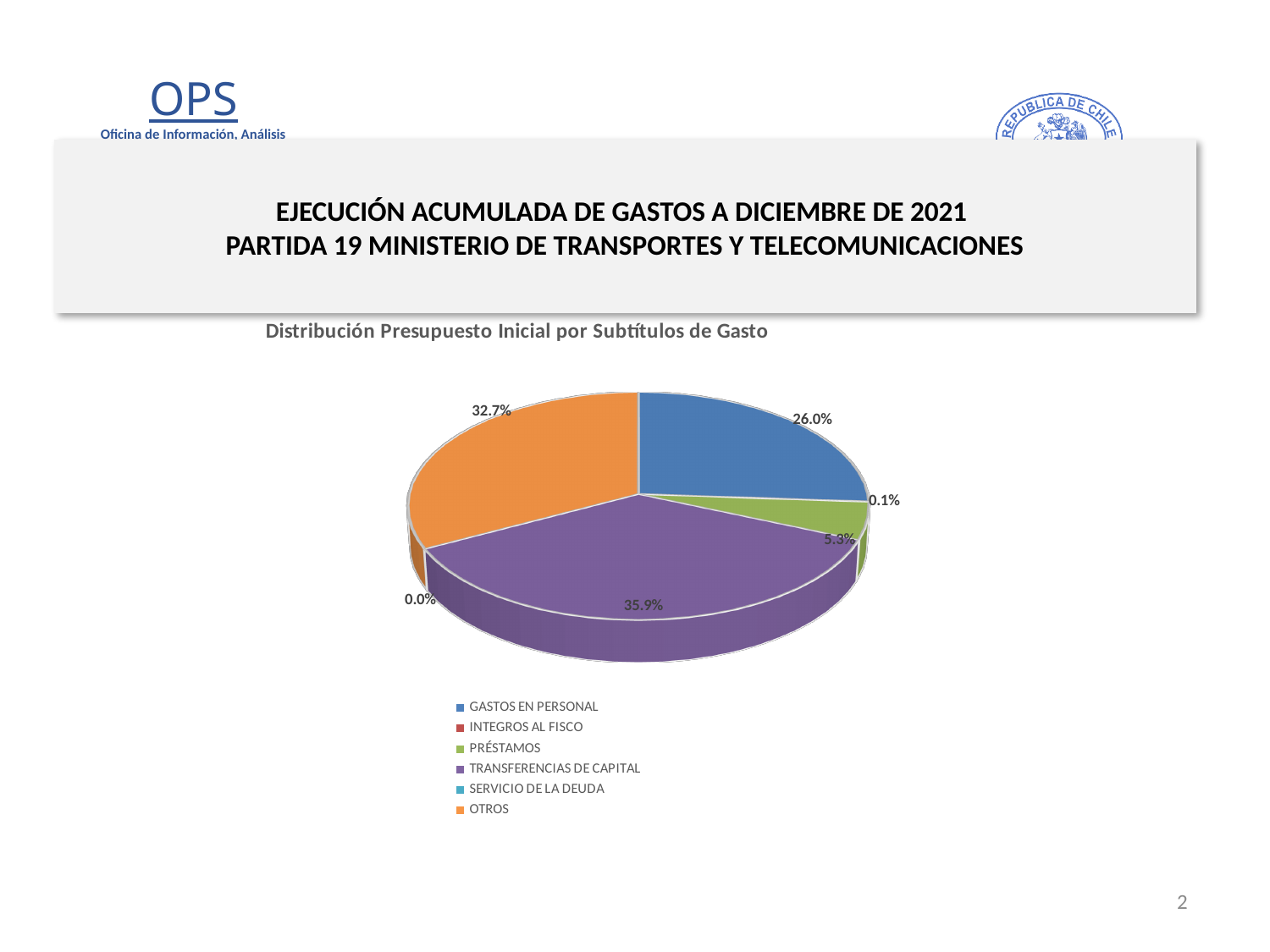
What share of the pie is TRANSFERENCIAS DE CAPITAL? 35.9% What is the difference between the shares for TRANSFERENCIAS DE CAPITAL and OTROS? 3.2% What share of the pie is OTROS? 32.7% What colour is the slice for OTROS? orange Which is larger, the share for OTROS or the share for GASTOS EN PERSONAL? OTROS What kind of chart is shown on the slide? pie chart What is the title of the chart? Distribución Presupuesto Inicial por Subtítulos de Gasto Which category has the largest share of the pie? TRANSFERENCIAS DE CAPITAL What share of the pie is GASTOS EN PERSONAL? 26.0% How many entries does the legend list? 6 What is the difference between the shares for GASTOS EN PERSONAL and PRÉSTAMOS? 20.7%